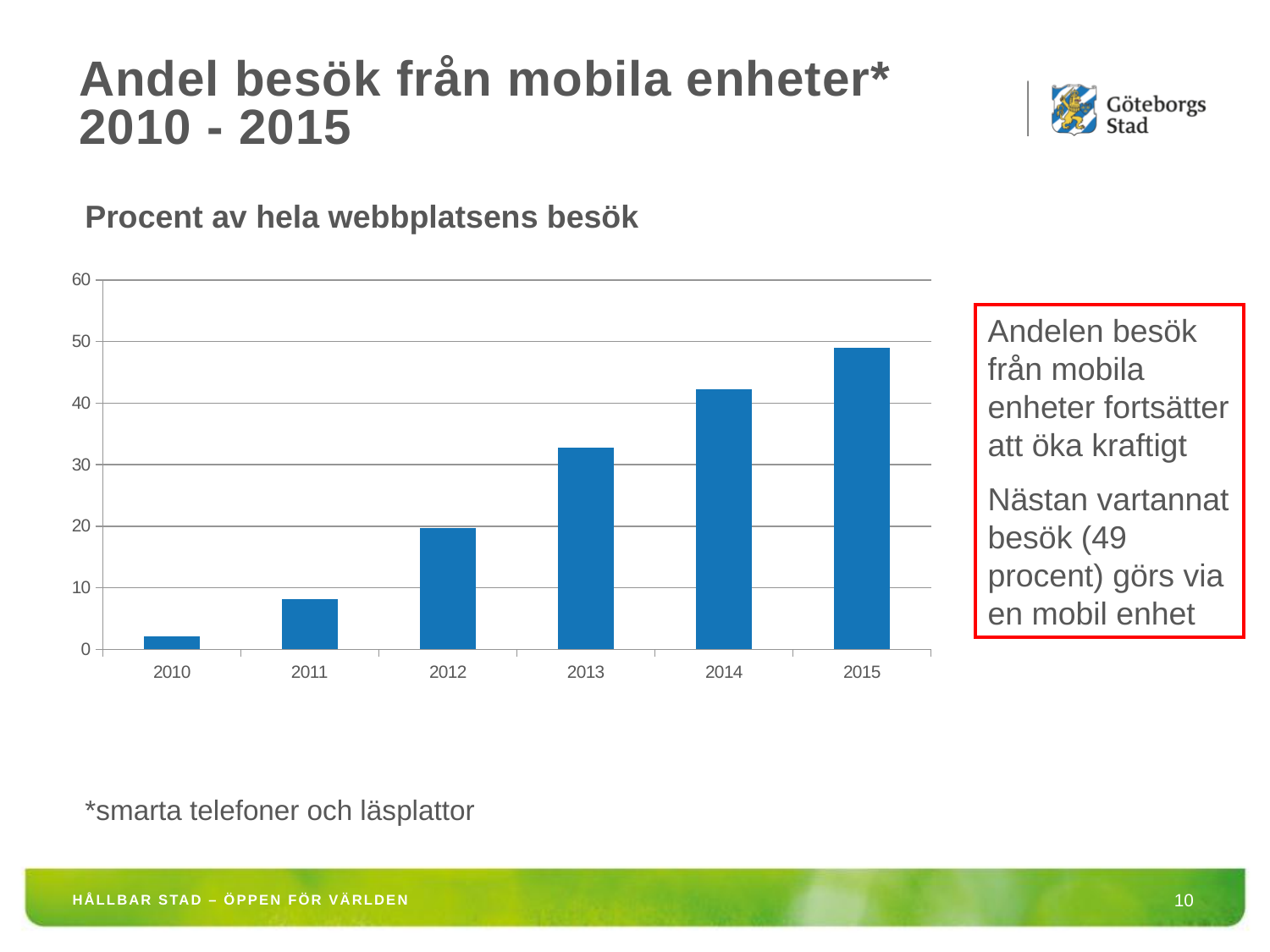
Is the value for 2013 greater or less than 30? greater What kind of chart is shown on the slide? bar chart Which is larger, the value for 2013 or the value for 2012? 2013 Is the value for 2011 greater or less than 10? less Is the value for 2014 greater or less than 40? greater Which year has the lowest share of visits from mobile devices? 2010 How many years are shown on the x axis of the chart? 6 Which year has the highest share of visits from mobile devices? 2015 Do the values rise or fall from 2010 to 2015? rise What is the title of the slide containing the chart? Andel besök från mobila enheter* 2010 - 2015 According to the text box on the slide, what percentage of visits were made via a mobile device in 2015? 49 procent